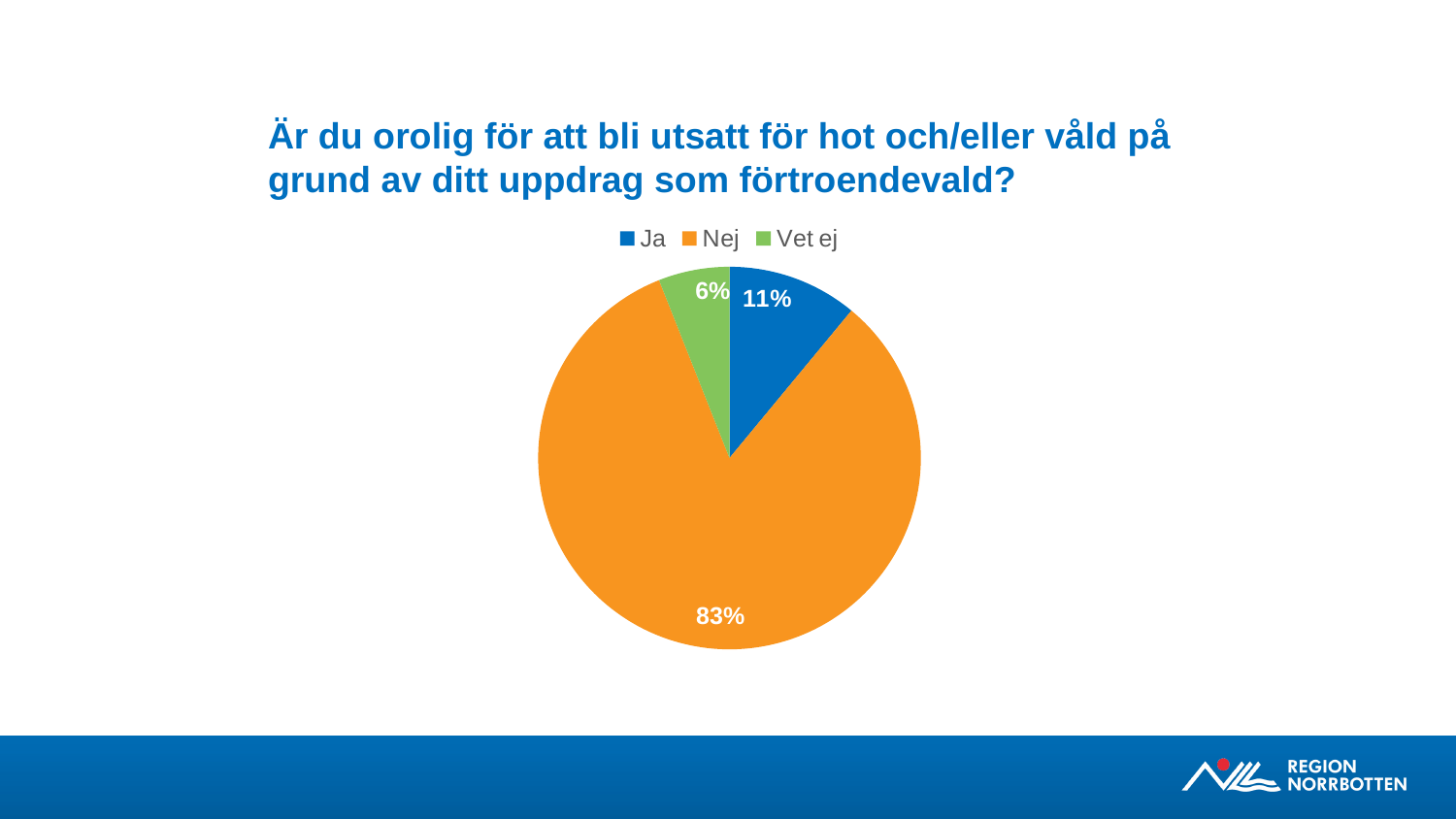
How many entries does the legend list? 3 What kind of chart is shown on the slide? pie chart Which category has the largest slice of the pie? Nej How many categories does the pie chart have? 3 What colour is the slice for "Nej"? orange What share of the pie does "Ja" have? 11% What is the difference in percentage points between "Nej" and "Ja"? 72 What is the difference in percentage points between "Ja" and "Vet ej"? 5 What share of the pie does "Vet ej" have? 6% What share of the pie does "Nej" have? 83% Which category has the smallest slice of the pie? Vet ej Which is larger, the slice for "Ja" or the slice for "Vet ej"? Ja